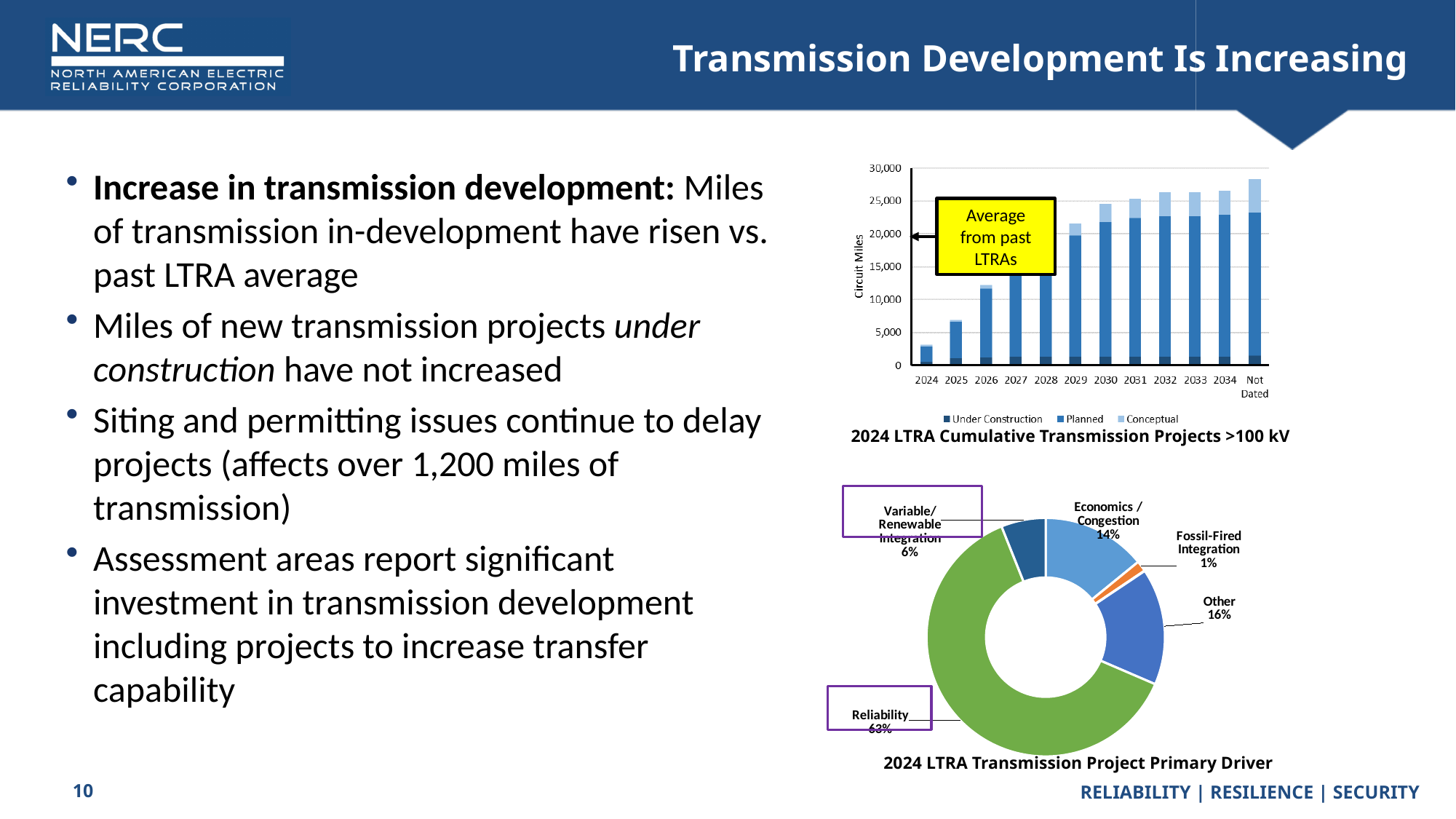
In the '2024 LTRA Transmission Project Primary Driver' chart, which is larger: Other or Variable/Renewable Integration? Other In the '2024 LTRA Transmission Project Primary Driver' chart, how many percentage points larger is Reliability than Other? 47 In the '2024 LTRA Transmission Project Primary Driver' chart, which driver has the largest share? Reliability What kind of chart is the '2024 LTRA Cumulative Transmission Projects >100 kV' chart? Stacked bar chart In the '2024 LTRA Transmission Project Primary Driver' chart, what share is labelled for Reliability? 63% How many slices does the '2024 LTRA Transmission Project Primary Driver' chart have? 5 How many series does the legend of the '2024 LTRA Cumulative Transmission Projects >100 kV' chart list? 3 In the '2024 LTRA Cumulative Transmission Projects >100 kV' chart, is the total for 2030 greater or less than 20,000 circuit miles? greater In the '2024 LTRA Cumulative Transmission Projects >100 kV' chart, do the bar totals generally rise or fall from 2024 to 2034? Rise In the '2024 LTRA Cumulative Transmission Projects >100 kV' chart, is the total for 2024 greater or less than 5,000 circuit miles? less In the '2024 LTRA Transmission Project Primary Driver' chart, what share is labelled for Economics / Congestion? 14% In the '2024 LTRA Transmission Project Primary Driver' chart, which driver has the smallest share? Fossil-Fired Integration